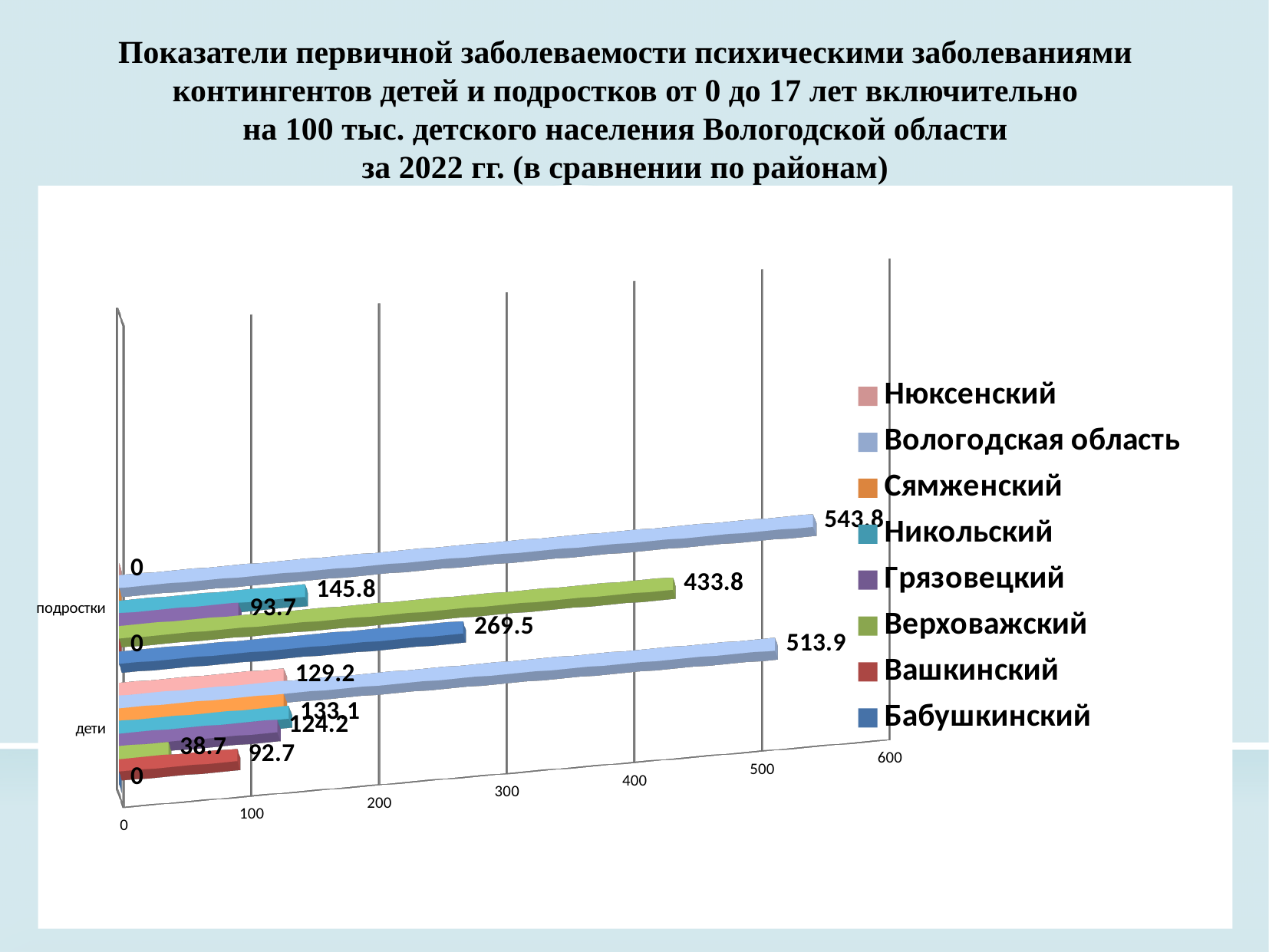
How many categories are shown on the vertical axis? 2 How many series does the legend list? 8 Which is larger in the подростки category: Верховажский or Бабушкинский? Верховажский What is the value for Бабушкинский in the подростки category? 269.5 What is the value for Нюксенский in the дети category? 129.2 What is the value for Вологодская область in the подростки category? 543.8 Which series has the highest value in the подростки category? Вологодская область What is the value for Верховажский in the подростки category? 433.8 What kind of chart is shown on the slide? Bar chart What is the value for Вологодская область in the дети category? 513.9 What is the difference between the Вологодская область values for подростки and дети? 29.9 What is the value for Верховажский in the дети category? 38.7